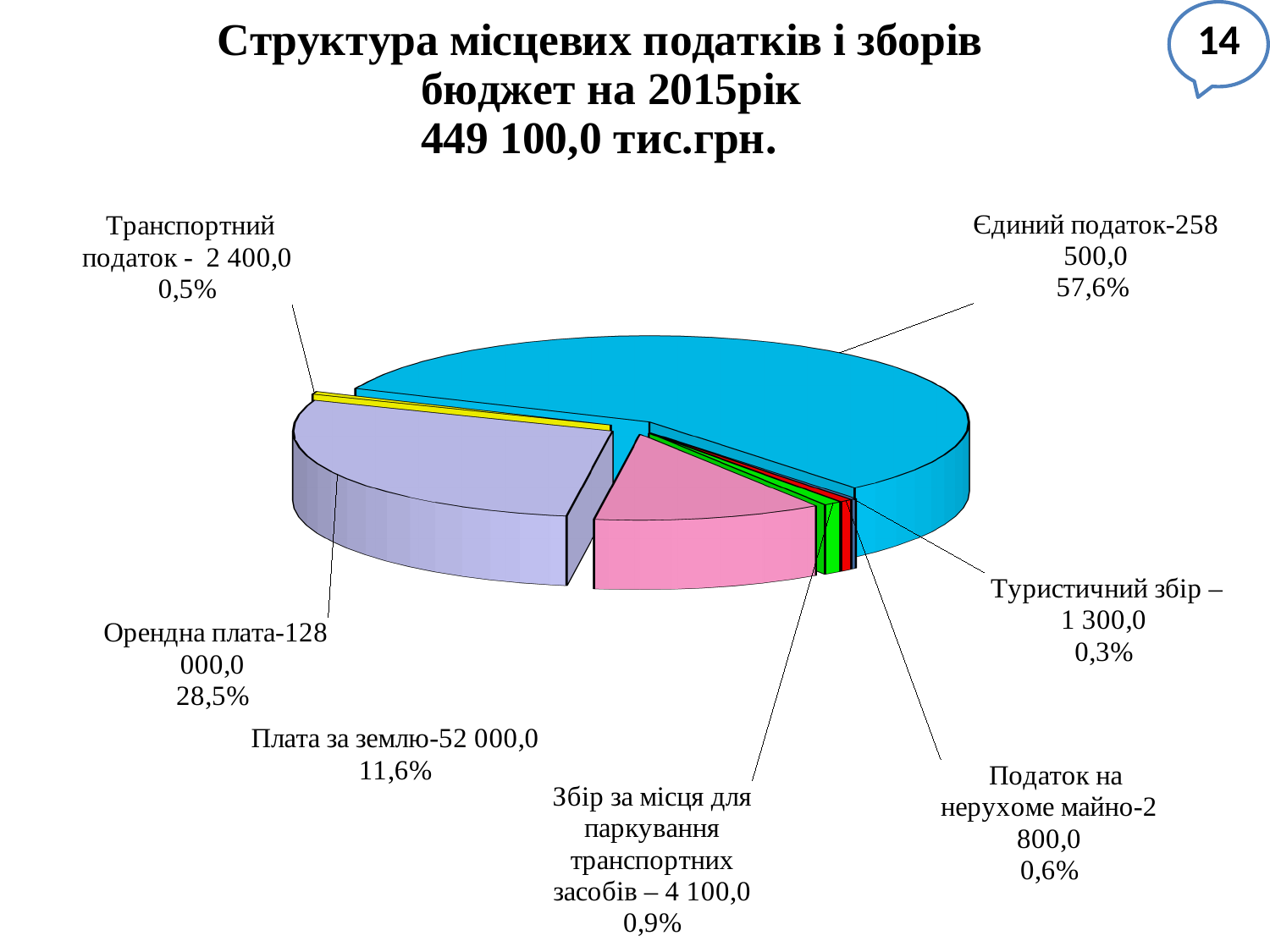
Which category has the smallest share of the pie? Туристичний збір What is the value shown for Орендна плата? 128 000,0 What type of chart is shown on the slide? Pie chart What total amount is stated in the chart title? 449 100,0 тис.грн. How many slices does the pie chart have? 7 What is the value shown for Збір за місця для паркування транспортних засобів? 4 100,0 Which is larger, Транспортний податок or Податок на нерухоме майно? Податок на нерухоме майно What is the difference in percentage points between Орендна плата and Плата за землю? 16,9% What is the value shown for Плата за землю? 52 000,0 What share of the pie does Єдиний податок represent? 57,6% Which category has the largest share of the pie? Єдиний податок What percentage is shown for Туристичний збір? 0,3%